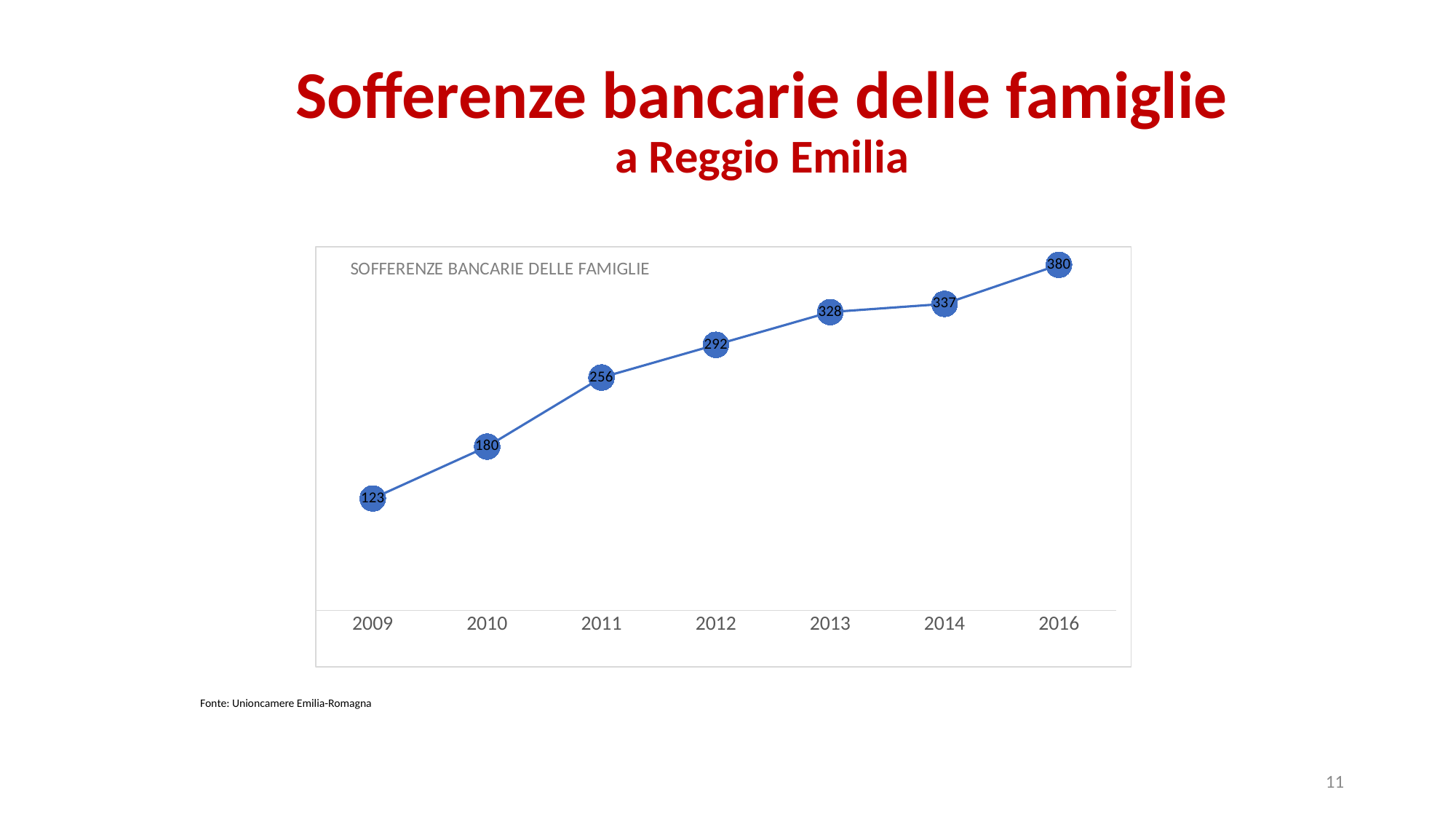
Which year has the lowest value? 2009 Do the values rise or fall from 2009 to 2016? rise What is the difference between the values for 2016 and 2009? 257 What is the value for 2016? 380 Which year has the highest value? 2016 How many years are plotted on the chart? 7 What is the value for 2012? 292 What kind of chart is shown? line chart What is the difference between the values for 2011 and 2010? 76 What is the title shown inside the chart area? SOFFERENZE BANCARIE DELLE FAMIGLIE Which is larger, the value for 2013 or the value for 2014? 2014 What is the value for 2009? 123